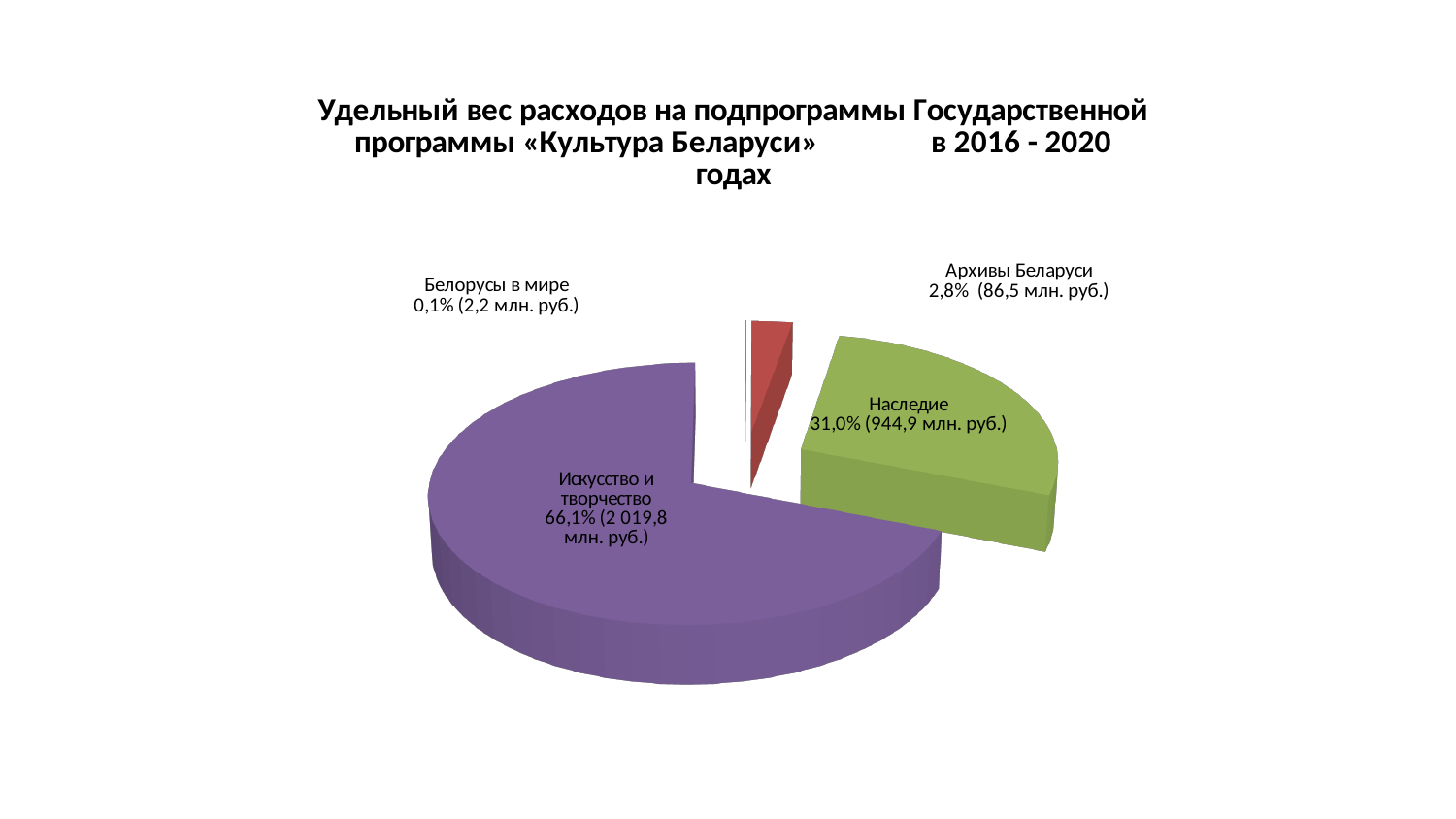
Which subprogramme has the smallest share of expenditure? Белорусы в мире Which has a larger share: «Архивы Беларуси» or «Белорусы в мире»? Архивы Беларуси What share of expenditure does the «Искусство и творчество» slice represent? 66,1% What amount in million rubles is shown for «Наследие»? 944,9 млн. руб. What type of chart is shown on the slide? Pie chart How many slices does the pie chart have? 4 What amount in million rubles is shown for «Белорусы в мире»? 2,2 млн. руб. What share of expenditure does the «Архивы Беларуси» slice represent? 2,8% What is the difference in percentage points between the shares of «Искусство и творчество» and «Наследие»? 35,1 Which subprogramme has the largest share of expenditure? Искусство и творчество What amount in million rubles is shown for «Архивы Беларуси»? 86,5 млн. руб. What share of expenditure does the «Наследие» slice represent? 31,0%